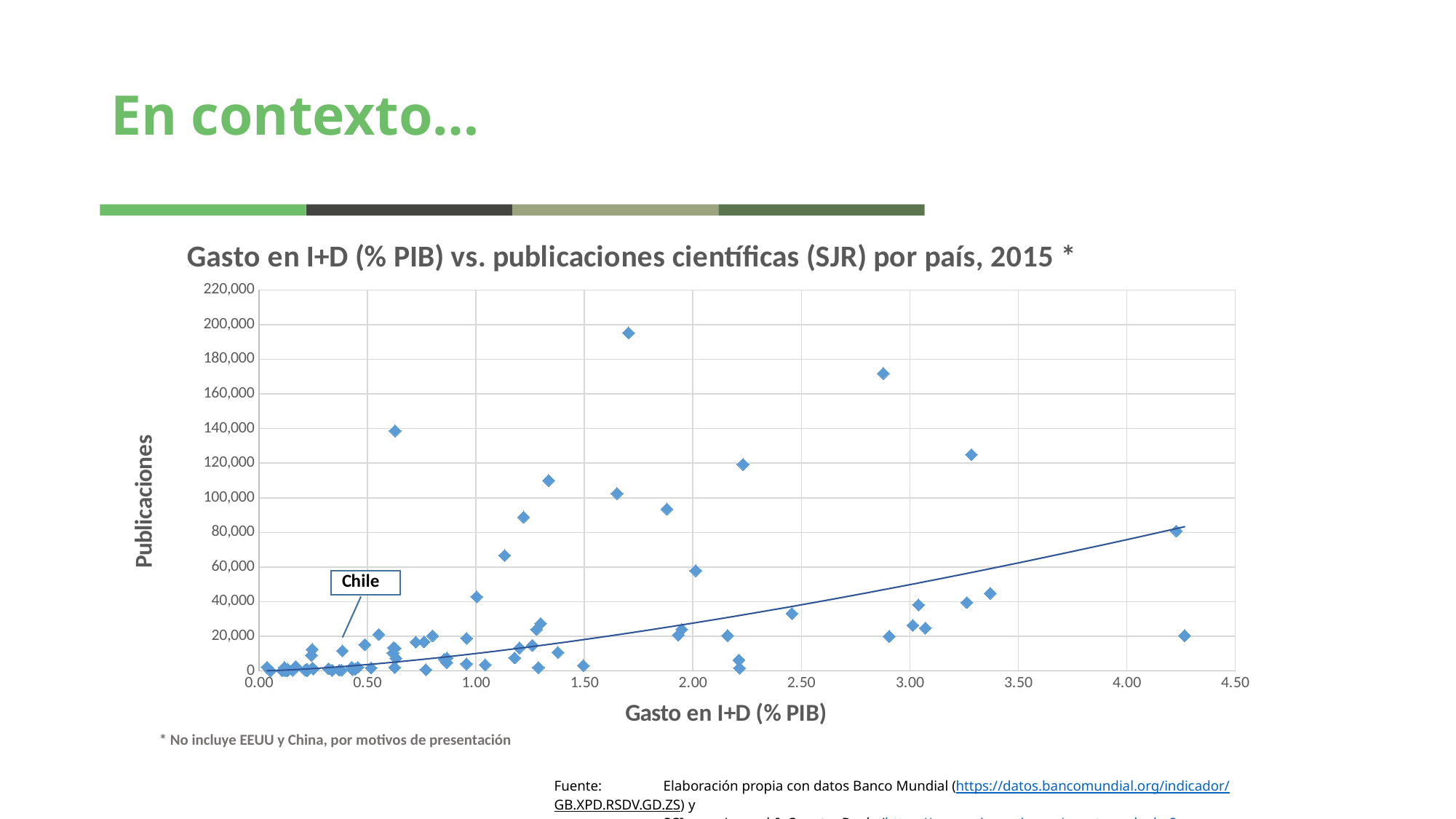
Which country is explicitly labeled on the chart? Chile According to the trend line, do publications rise or fall as R&D spending (% PIB) increases? rise What is the maximum value shown on the horizontal axis? 4.50 Is the point with the highest R&D spending (% PIB) greater or less than 40,000 publications? less What is the label of the vertical axis of the chart? Publicaciones Is the highest point on the chart greater or less than 180,000 publications? greater Is the point with the highest R&D spending (% PIB) greater or less than 4.00? greater What is the maximum value shown on the vertical axis? 220,000 What kind of chart is shown on the slide? scatter chart What is the title of the chart? Gasto en I+D (% PIB) vs. publicaciones científicas (SJR) por país, 2015 *